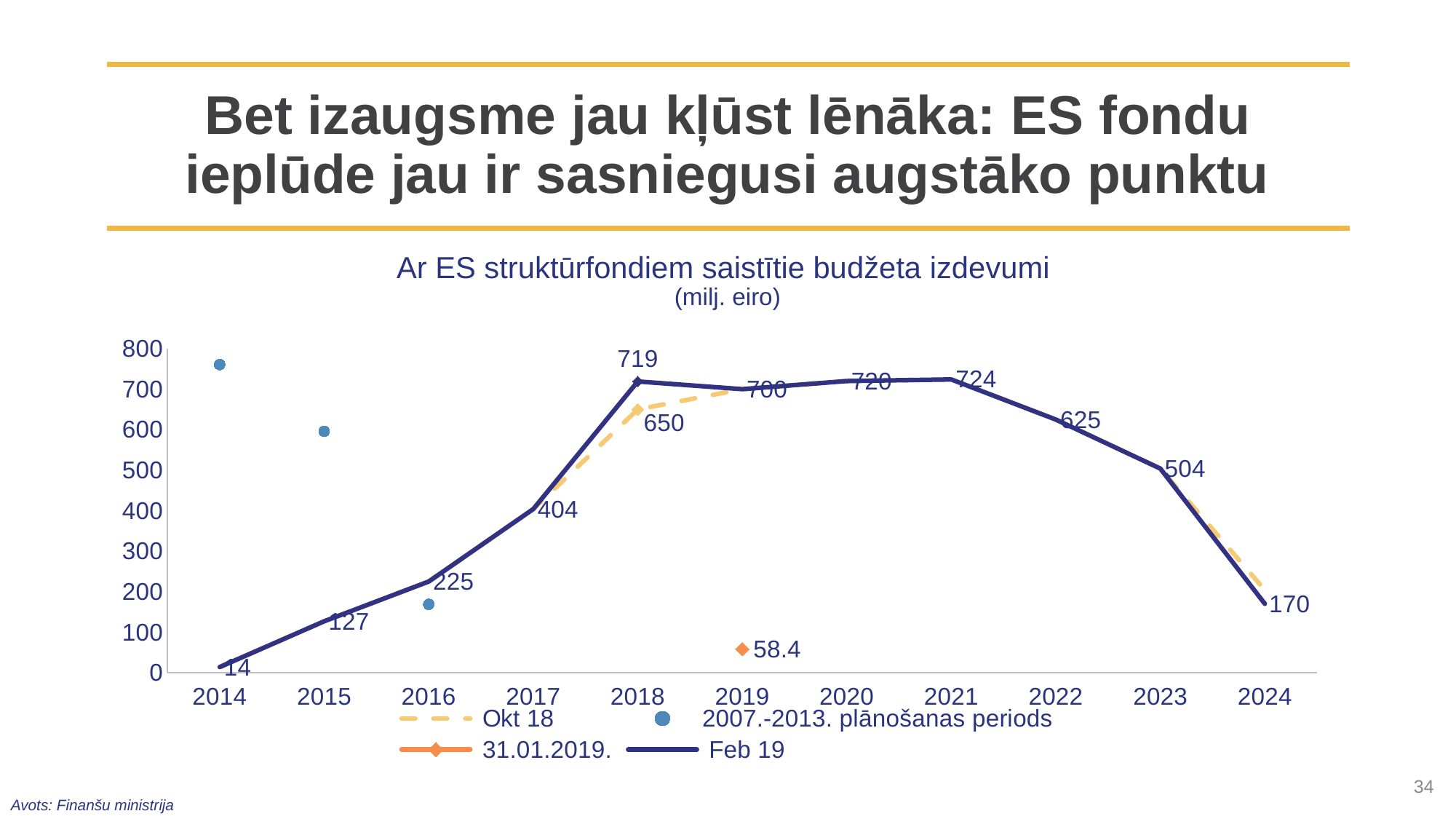
Does the Feb 19 series rise or fall from 2021 to 2024? fall What is the difference between the Feb 19 value (719) and the Okt 18 value (650) in 2018? 69 Which year has the larger Feb 19 value, 2022 or 2023? 2022 In which year does the Feb 19 series reach its highest value? 2021 How many series does the legend list? 4 What is the Feb 19 value for 2018? 719 What is the difference between the Feb 19 values for 2018 and 2017? 315 Is the 2007.-2013. plānošanas periods value for 2014 greater or less than 700? greater How many years are shown on the x axis? 11 What is the Feb 19 value for 2024? 170 In which year does the Feb 19 series have its lowest value? 2014 What value is labelled for the 31.01.2019. series in 2019? 58.4